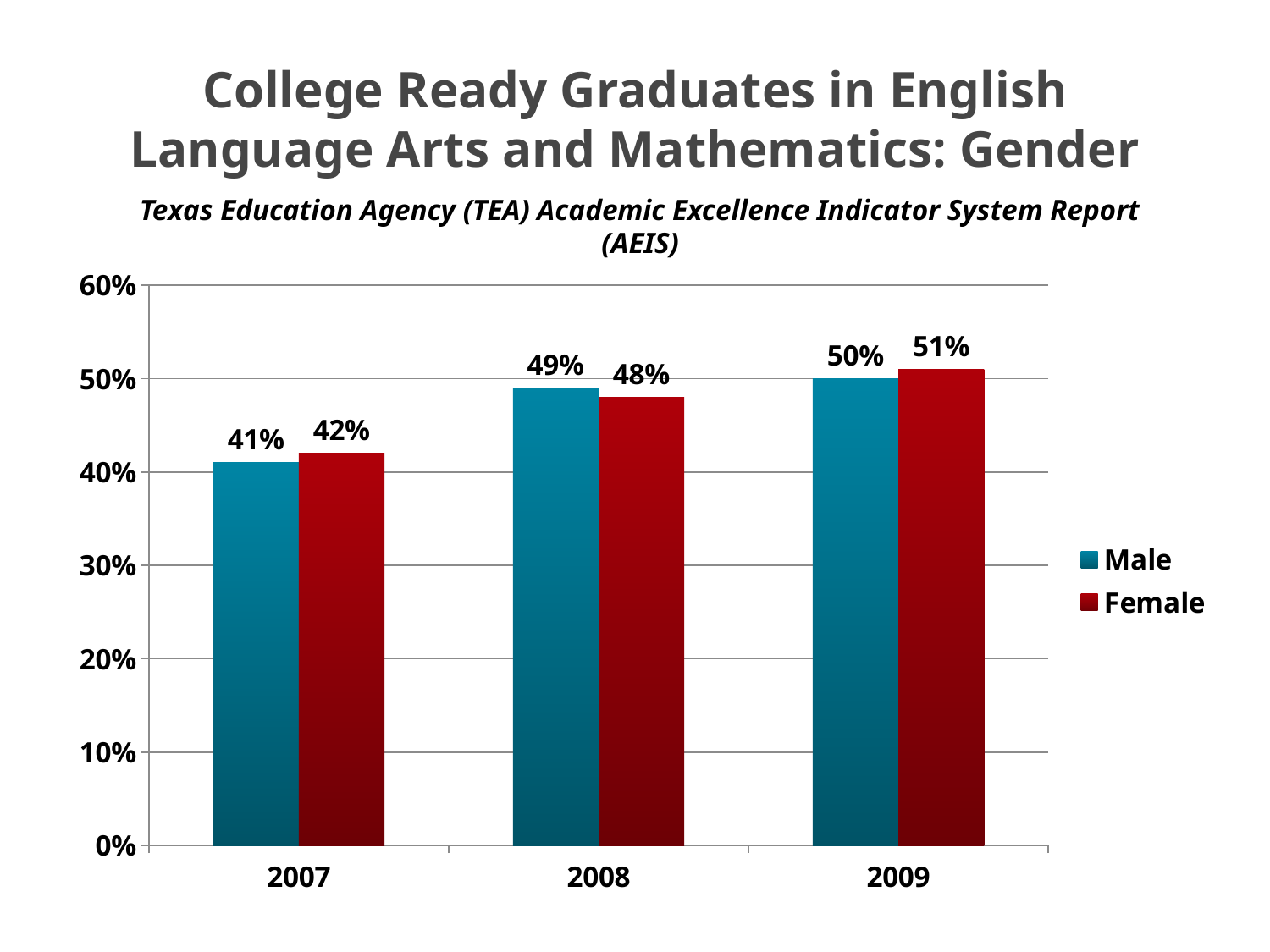
What is the difference between the Male values in 2008 and 2007? 8% How many series does the legend list? 2 What is the value for Male in 2007? 41% Is the value for Female in 2007 greater or less than 50%? less What kind of chart is shown on the slide? bar chart How many years are shown on the x axis? 3 What is the value for Female in 2009? 51% Which is larger in 2008, the Male value or the Female value? Male In which year is the Female value lowest? 2007 What is the value for Female in 2008? 48% In which year is the Male value highest? 2009 Do the Male values rise or fall from 2007 to 2009? rise